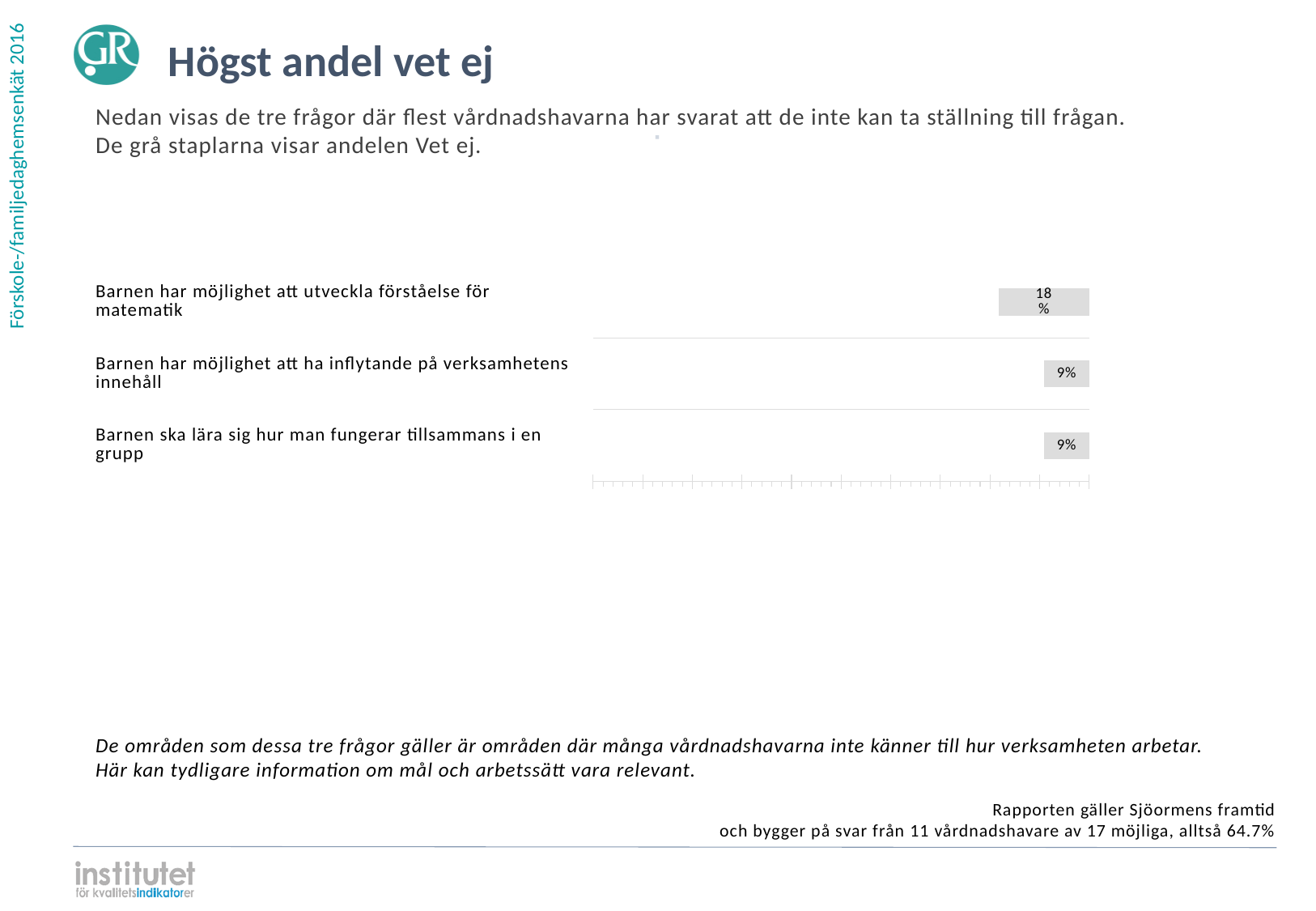
What is the difference between the value for "Barnen har möjlighet att utveckla förståelse för matematik" and the value for "Barnen har möjlighet att ha inflytande på verksamhetens innehåll"? 9 percentage points Which is larger: the value for "Barnen har möjlighet att utveckla förståelse för matematik" or the value for "Barnen ska lära sig hur man fungerar tillsammans i en grupp"? Barnen har möjlighet att utveckla förståelse för matematik Do the values decrease or increase going from the top category to the bottom category? Decrease What is the value shown for "Barnen har möjlighet att ha inflytande på verksamhetens innehåll"? 9% How many categories are shown in the chart? 3 What kind of chart is shown on the slide? Bar chart What colour are the bars in the chart? Grey Which category has the highest share of "Vet ej" answers? Barnen har möjlighet att utveckla förståelse för matematik What is the title of the slide containing the chart? Högst andel vet ej What is the value shown for "Barnen har möjlighet att utveckla förståelse för matematik"? 18% What is the value shown for "Barnen ska lära sig hur man fungerar tillsammans i en grupp"? 9%